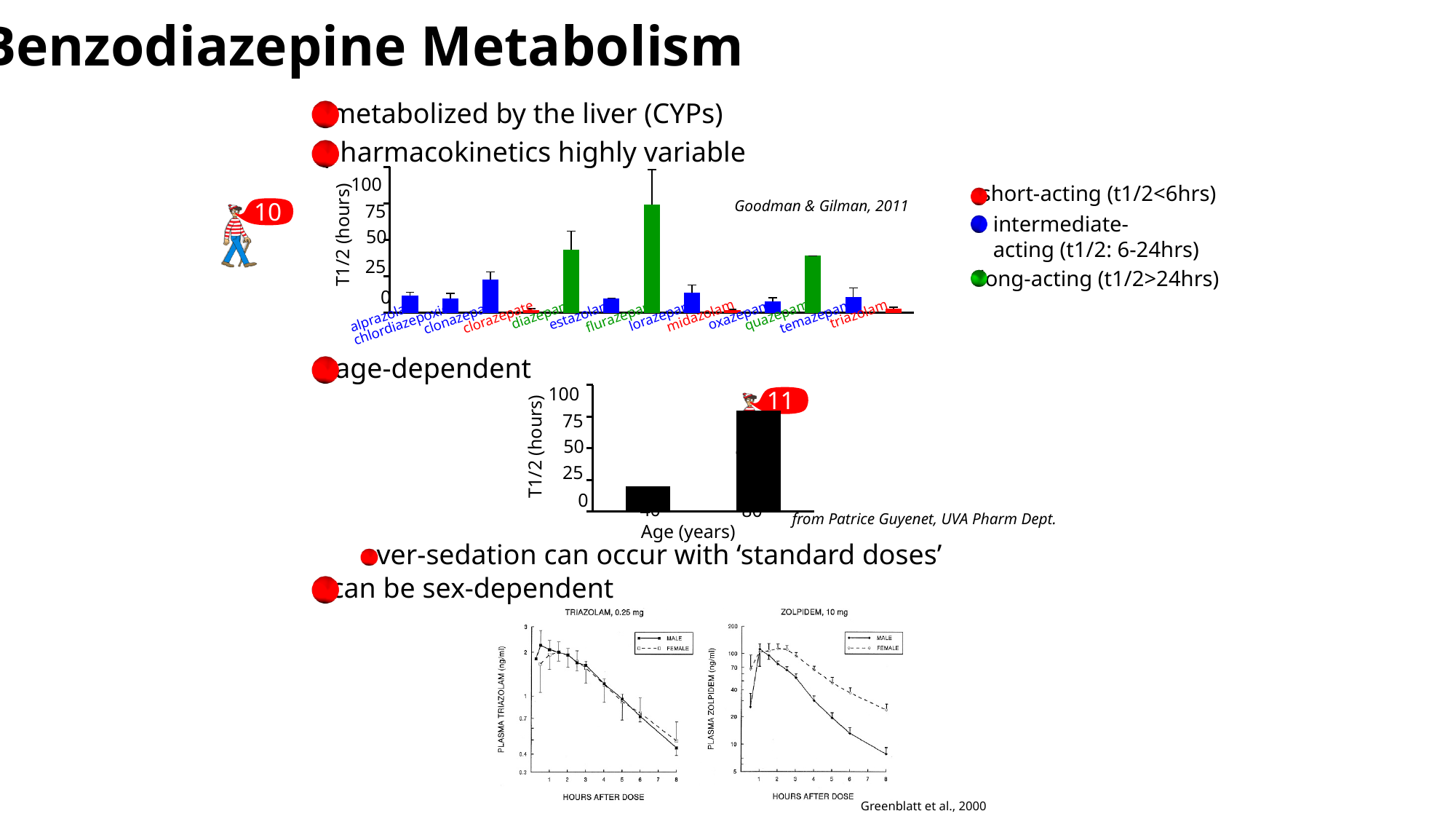
In the middle chart of T1/2 (hours) against Age (years), is the value for age 40 greater or less than 25? less In the middle chart of T1/2 (hours) against Age (years), which age group has the higher half-life? 80 In the top chart of T1/2 (hours) by benzodiazepine, is the value for flurazepam greater or less than 50? greater How many drugs are plotted on the x axis of the top chart of T1/2 (hours) by benzodiazepine? 13 In the top chart of T1/2 (hours) by benzodiazepine, is the value for diazepam greater or less than 25? greater In the top chart of T1/2 (hours) by benzodiazepine, which has the larger half-life, diazepam or clonazepam? diazepam In the bottom-right chart titled ZOLPIDEM, 10 mg, at 8 hours after dose, which series has the higher plasma zolpidem level, MALE or FEMALE? FEMALE What kind of chart is the middle chart of T1/2 (hours) against Age (years)? bar chart In the top chart of T1/2 (hours) by benzodiazepine, what colour are the bars for long-acting drugs? green How many series does the legend list in the bottom-right chart titled ZOLPIDEM, 10 mg? 2 In the top chart of T1/2 (hours) by benzodiazepine, which drug has the highest half-life? flurazepam